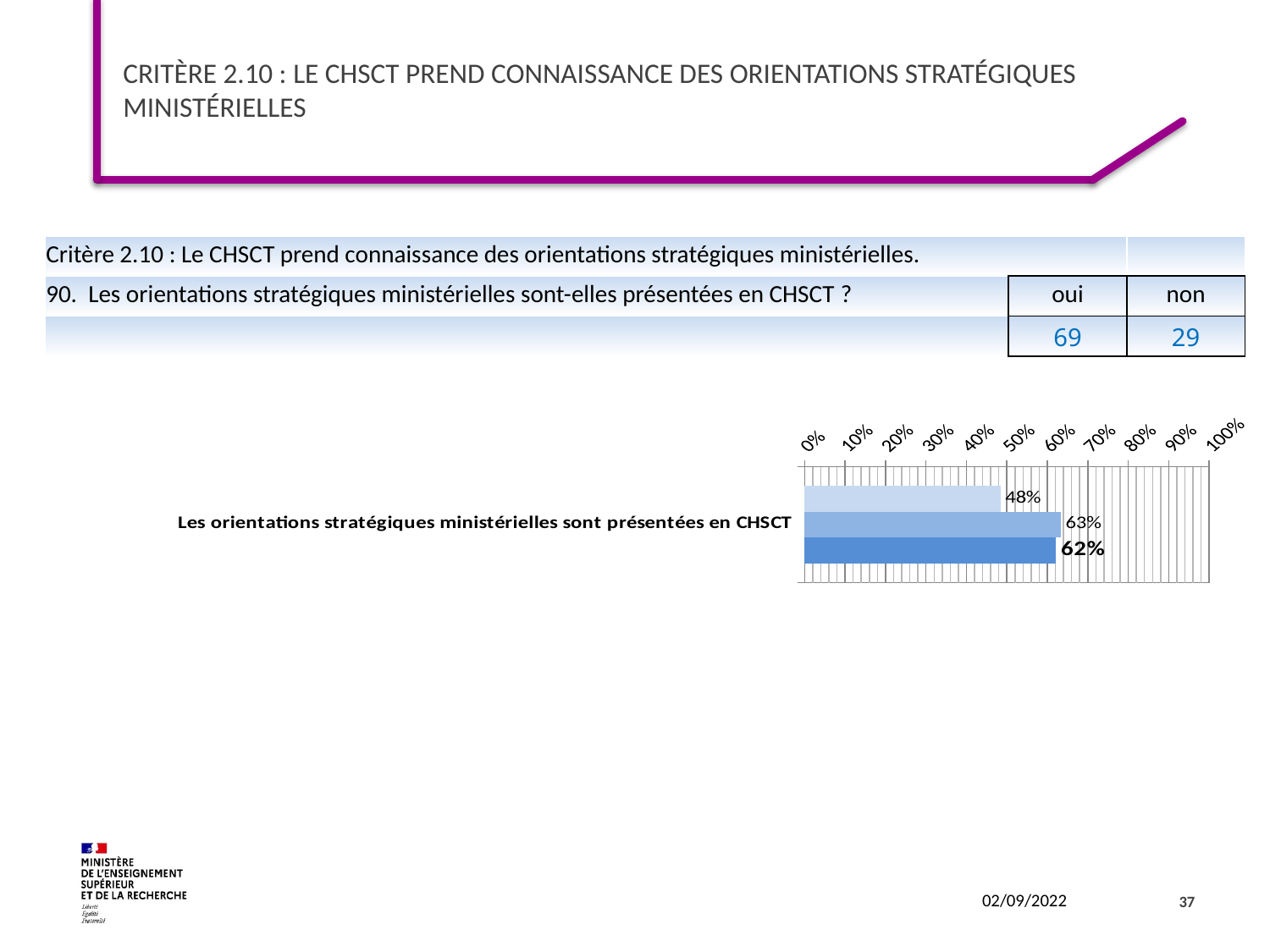
Is the value of the top bar greater or less than 50%? less Which bar has the lowest value: the top, middle or bottom bar? top Which bar has the highest value: the top, middle or bottom bar? middle What is the maximum value shown on the chart's horizontal axis? 100% How many bars are plotted for the category 'Les orientations stratégiques ministérielles sont présentées en CHSCT'? 3 How many categories are shown on the chart's vertical axis? 1 What value is labelled on the top (lightest) bar of the chart? 48% What value is labelled on the middle bar of the chart? 63% Which is larger, the value of the top bar or the value of the bottom bar? the bottom bar What value is labelled on the bottom (darkest) bar of the chart? 62% What is the difference between the middle bar's value and the top bar's value? 15 percentage points What kind of chart is shown on the slide? bar chart